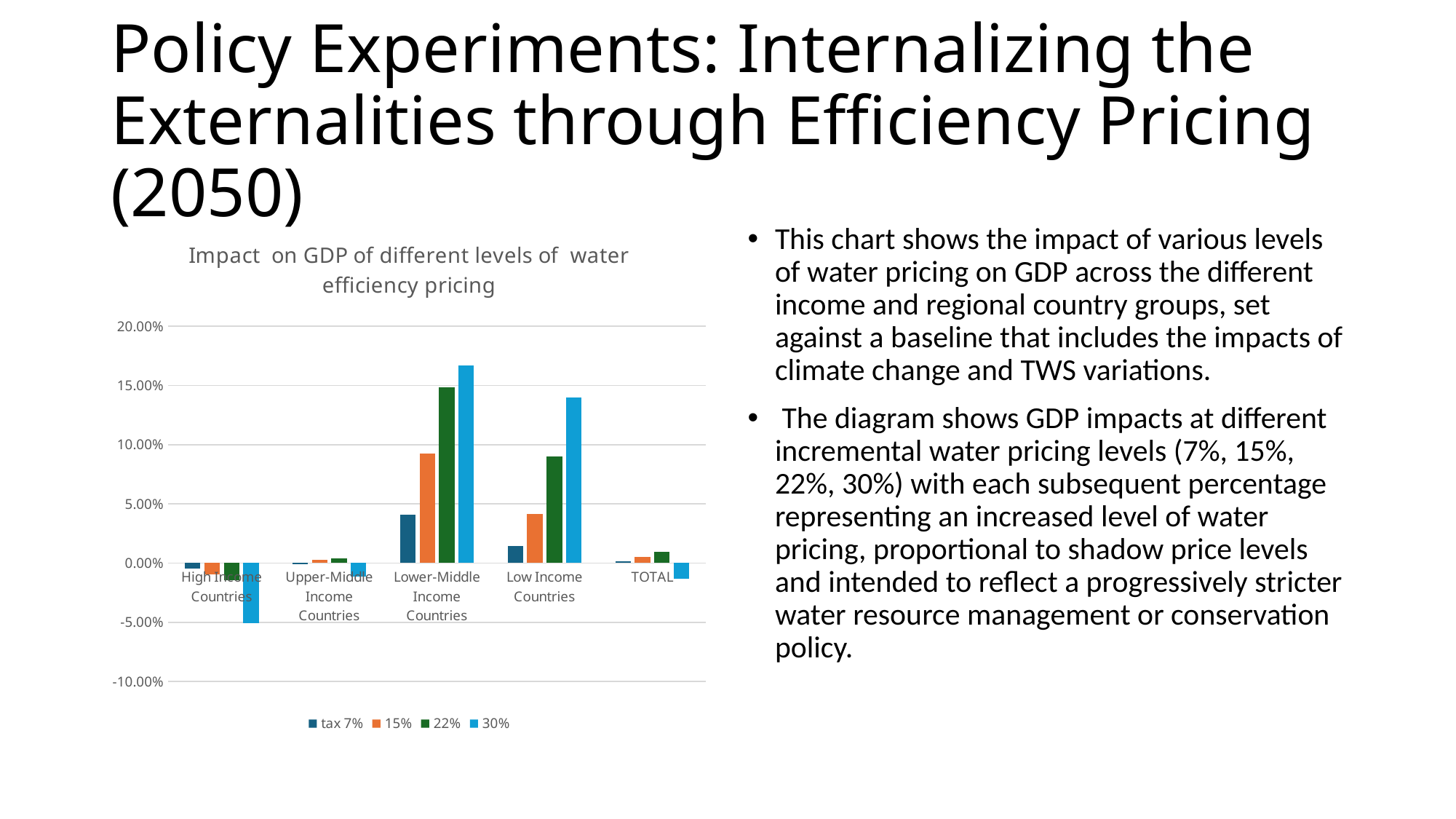
Is the 30% value for High Income Countries greater or less than 0.00%? less For Lower-Middle Income Countries, do the values rise or fall from the tax 7% series to the 30% series? rise Which is larger, the 22% value for Lower-Middle Income Countries or the 22% value for Low Income Countries? Lower-Middle Income Countries What is the title of the chart? Impact on GDP of different levels of water efficiency pricing How many country-group categories are shown on the x axis? 5 How many series does the legend list? 4 What kind of chart is shown on the slide? bar chart Which category has the lowest value for the 30% series? High Income Countries Is the 30% value for Lower-Middle Income Countries greater or less than 15.00%? greater Which category has the highest value for the 30% series? Lower-Middle Income Countries Is the 22% value for Low Income Countries greater or less than 10.00%? less What is the first entry in the chart's legend? tax 7%